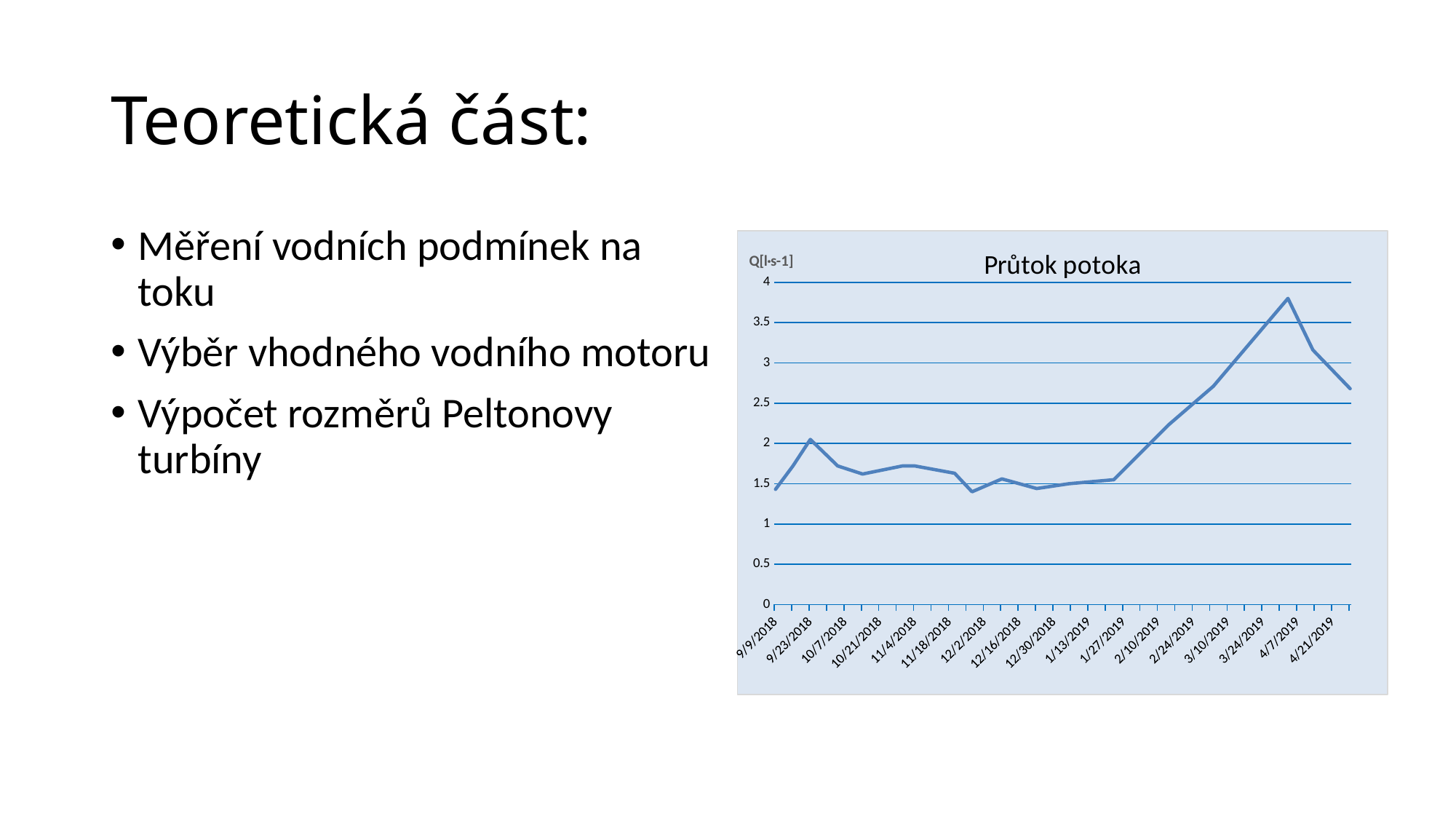
Which is larger, the value for 9/23/2018 or the value for 10/21/2018? 9/23/2018 What kind of chart is shown on the slide? line chart Which is larger, the value for 4/7/2019 or the value for 9/23/2018? 4/7/2019 Do the values rise or fall between 1/27/2019 and 4/7/2019? rise Is the value for 2/24/2019 greater or less than 2? greater What is the title of the chart? Průtok potoka Is the value for 9/23/2018 greater or less than 2? greater Is the value for 1/27/2019 greater or less than 2? less What label is shown on the vertical axis of the chart? Q[l·s-1]